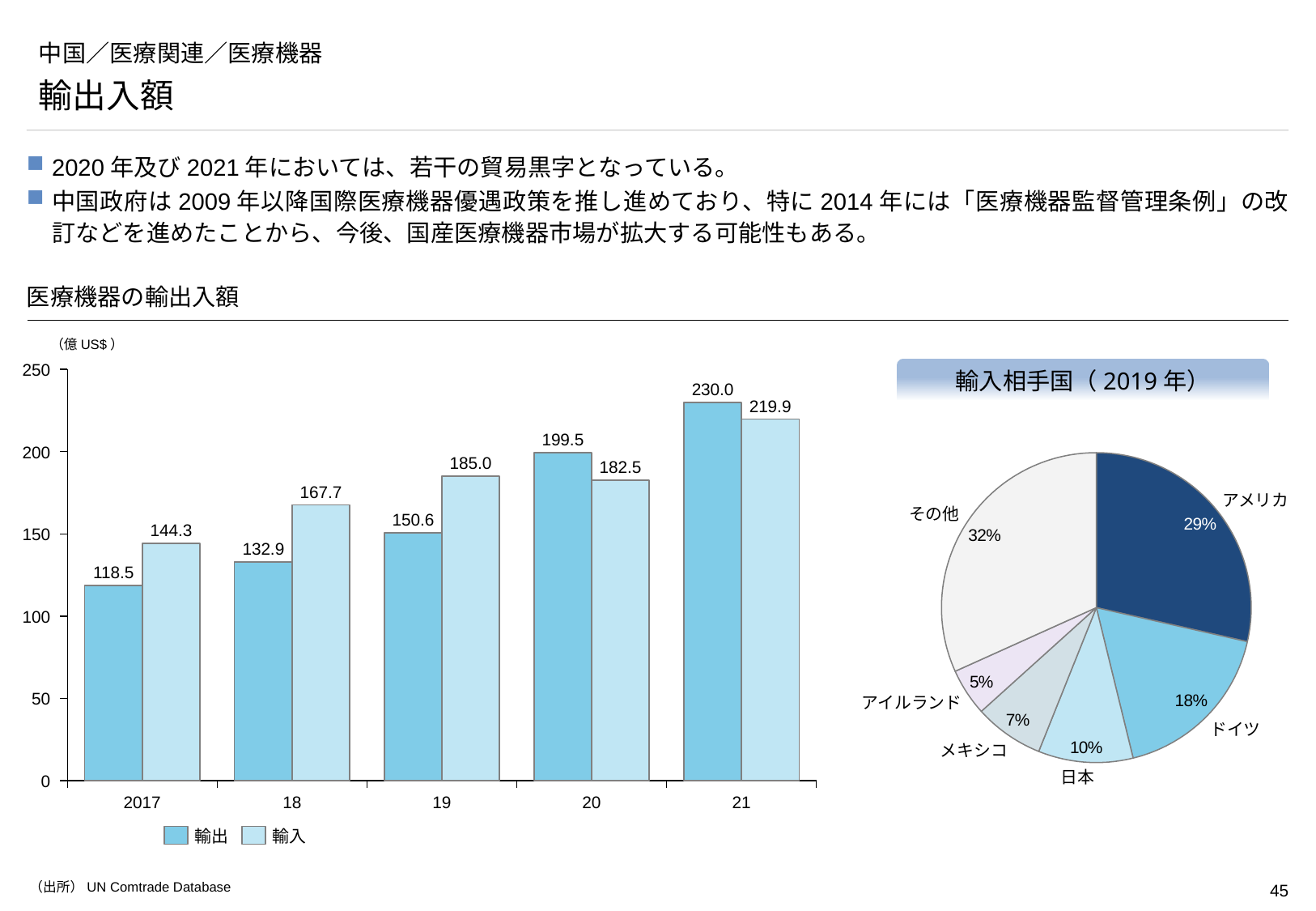
In the bar chart 医療機器の輸出入額, what is the difference between 輸出 and 輸入 in 21? 10.1 In the bar chart 医療機器の輸出入額, which is larger in 20, 輸出 or 輸入? 輸出 In the bar chart 医療機器の輸出入額, what is the 輸入 value for 19? 185.0 In the bar chart 医療機器の輸出入額, how many series does the legend list? 2 In the pie chart 輸入相手国 (2019年), what share does アメリカ have? 29% In the bar chart 医療機器の輸出入額, what is the 輸出 value for 2017? 118.5 In the bar chart 医療機器の輸出入額, does the 輸出 value rise or fall from 2017 to 21? rise In the pie chart 輸入相手国 (2019年), how many slices are there? 6 In the bar chart 医療機器の輸出入額, which year has the lowest 輸入 value? 2017 In the pie chart 輸入相手国 (2019年), which named country has the smallest share? アイルランド What kind of chart is 医療機器の輸出入額? bar chart In the bar chart 医療機器の輸出入額, which year has the highest 輸出 value? 21